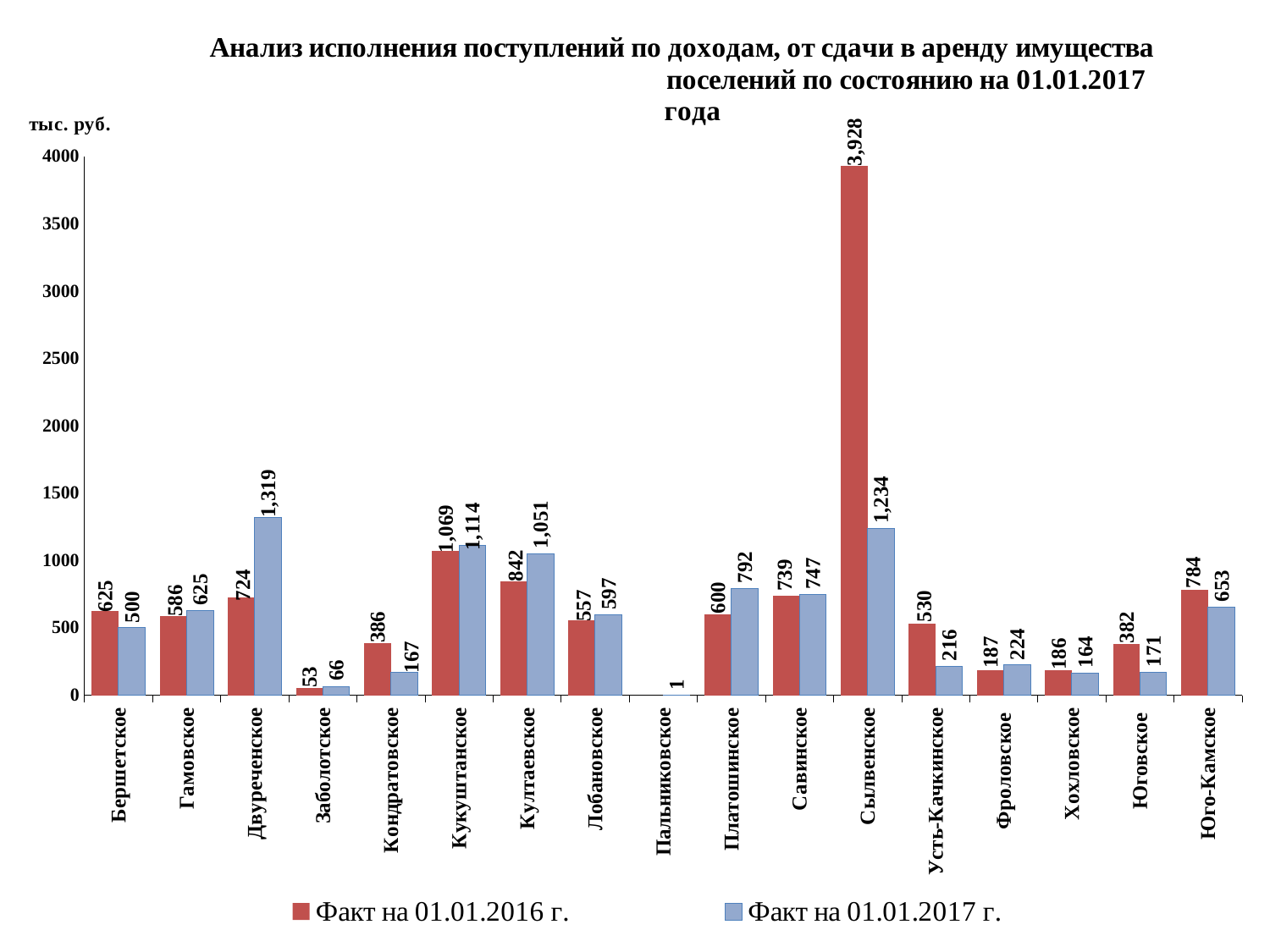
Which category has the highest value in the series Факт на 01.01.2017 г.? Двуреченское What is the value for Двуреченское in the series Факт на 01.01.2017 г.? 1,319 Which is larger for Усть-Качкинское: the value for Факт на 01.01.2016 г. or Факт на 01.01.2017 г.? Факт на 01.01.2016 г. What colour are the bars for the series Факт на 01.01.2017 г.? blue Which category has the highest value in the series Факт на 01.01.2016 г.? Сылвенское What is the value for Сылвенское in the series Факт на 01.01.2016 г.? 3,928 What is the value for Кондратовское in the series Факт на 01.01.2016 г.? 386 What is the difference between the Факт на 01.01.2016 г. and Факт на 01.01.2017 г. values for Сылвенское? 2,694 What unit is shown on the vertical axis label? тыс. руб. How many series does the legend list? 2 What is the difference between the Факт на 01.01.2017 г. and Факт на 01.01.2016 г. values for Платошинское? 192 What type of chart is shown on the slide? bar chart